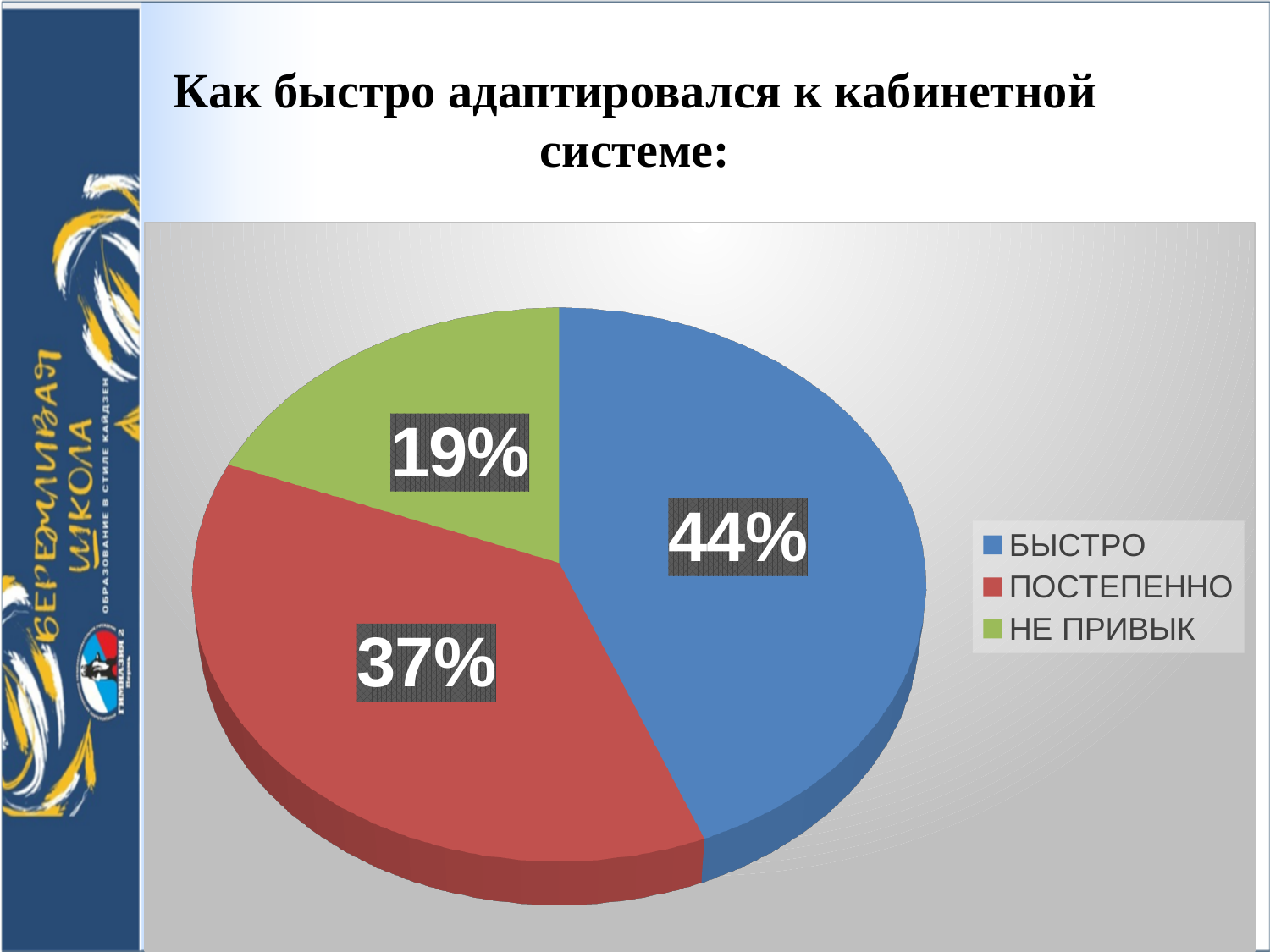
What kind of chart is shown on the slide? pie chart What share of the pie does ПОСТЕПЕННО have? 37% What share of the pie does НЕ ПРИВЫК have? 19% What share of the pie does БЫСТРО have? 44% What is the difference in percentage points between ПОСТЕПЕННО and НЕ ПРИВЫК? 18 What is the difference in percentage points between БЫСТРО and ПОСТЕПЕННО? 7 Which is larger, the slice for ПОСТЕПЕННО or the slice for НЕ ПРИВЫК? ПОСТЕПЕННО Which category has the largest slice of the pie? БЫСТРО Which category has the smallest slice of the pie? НЕ ПРИВЫК How many entries does the legend list? 3 How many slices does the pie chart have? 3 What colour is the slice for НЕ ПРИВЫК? green